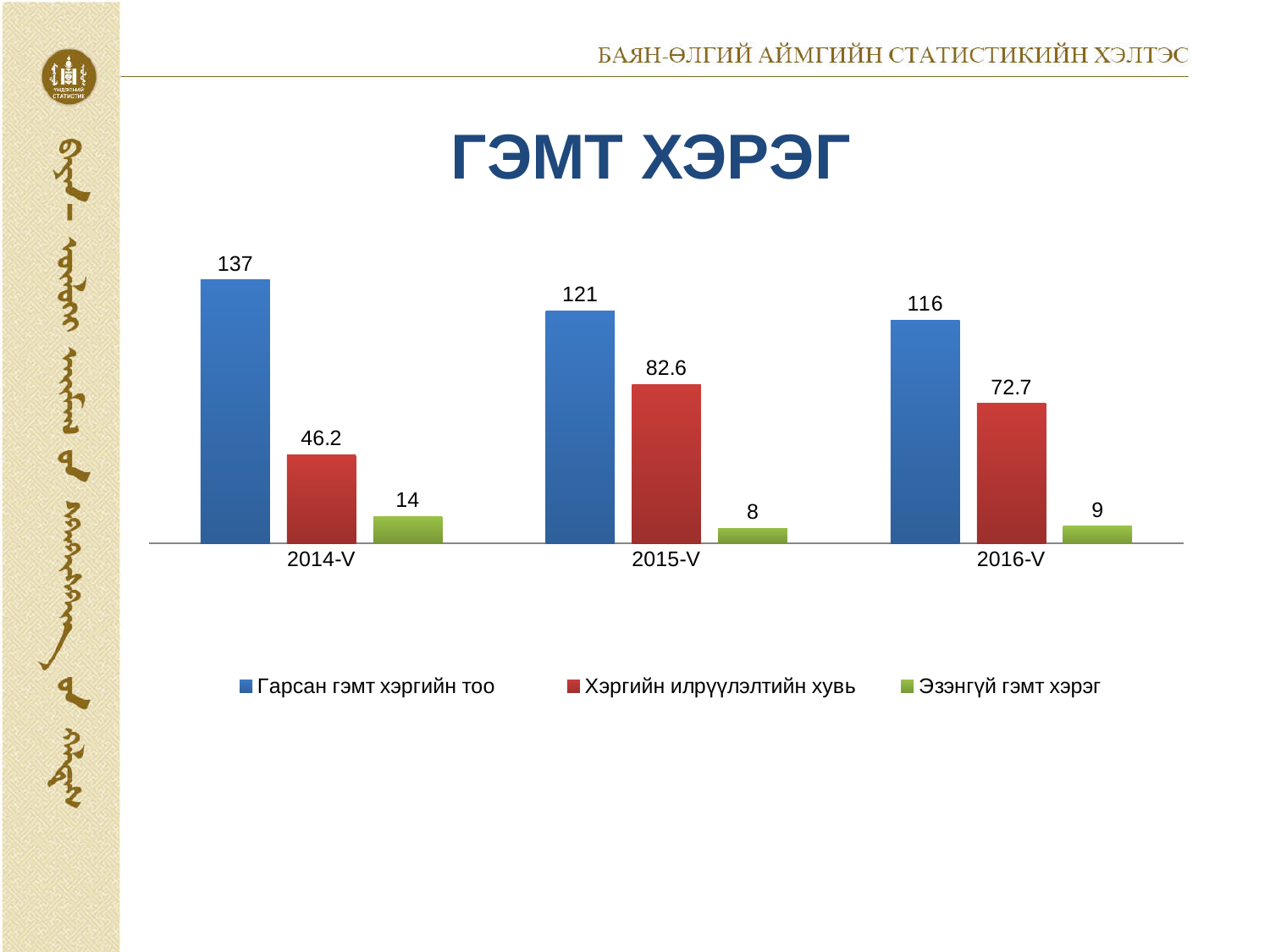
What is the value of Гарсан гэмт хэргийн тоо for 2014-V? 137 Which period has the highest value for Гарсан гэмт хэргийн тоо? 2014-V What is the title of the chart? ГЭМТ ХЭРЭГ What is the value of Эзэнгүй гэмт хэрэг for 2016-V? 9 What is the difference between Гарсан гэмт хэргийн тоо in 2014-V and 2016-V? 21 How many periods are shown on the x axis? 3 What is the value of Хэргийн илрүүлэлтийн хувь for 2015-V? 82.6 Which period has the lowest value for Хэргийн илрүүлэлтийн хувь? 2014-V How many series does the legend list? 3 What kind of chart is shown on the slide? Bar chart Does Гарсан гэмт хэргийн тоо rise or fall from 2014-V to 2016-V? Fall Which is larger: Хэргийн илрүүлэлтийн хувь in 2015-V or in 2016-V? 2015-V